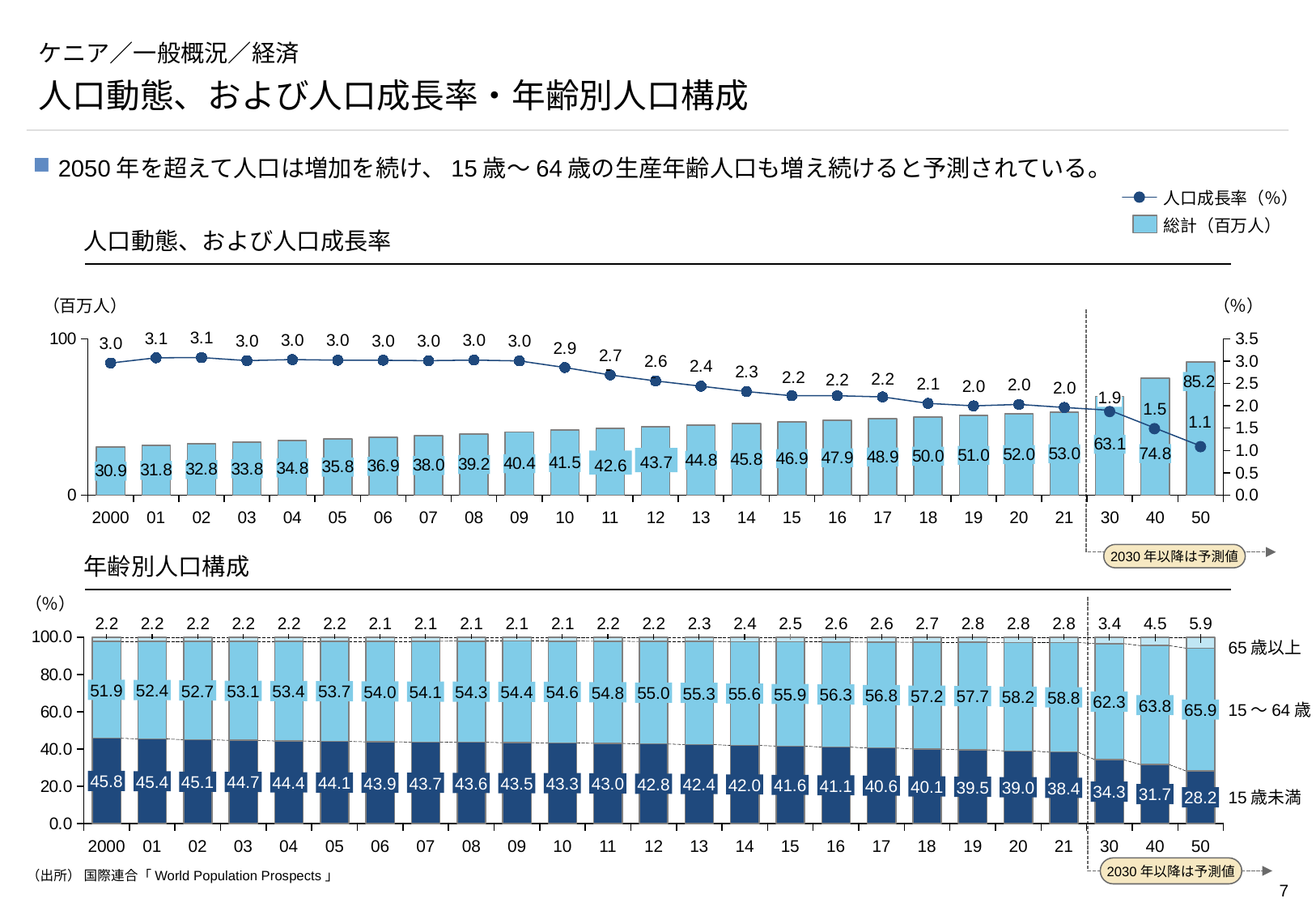
In the top chart (人口動態、および人口成長率), what is the population growth rate (人口成長率) shown for 2010? 2.9 In the bottom chart (年齢別人口構成), what is the share of the 15～64歳 group in 2040? 63.8 How many series does the legend of the top chart (人口動態、および人口成長率) list? 2 In the top chart (人口動態、および人口成長率), how many years are shown on the x axis? 25 In the bottom chart (年齢別人口構成), what is the share of the 65歳以上 group in 2050? 5.9 In the top chart (人口動態、および人口成長率), which year has the lowest population growth rate? 2050 In the top chart (人口動態、および人口成長率), which year has the highest total population? 2050 In the top chart (人口動態、および人口成長率), by how much does the total population in 2021 exceed that in 2000? 22.1 In the bottom chart (年齢別人口構成), does the share of the 15歳未満 group rise or fall from 2000 to 2050? Fall What kind of chart is the bottom chart (年齢別人口構成)? Stacked bar chart In the top chart (人口動態、および人口成長率), what is the total population (総計) shown for 2050? 85.2 In the top chart (人口動態、および人口成長率), is the population growth rate higher in 2015 or in 2020? 2015